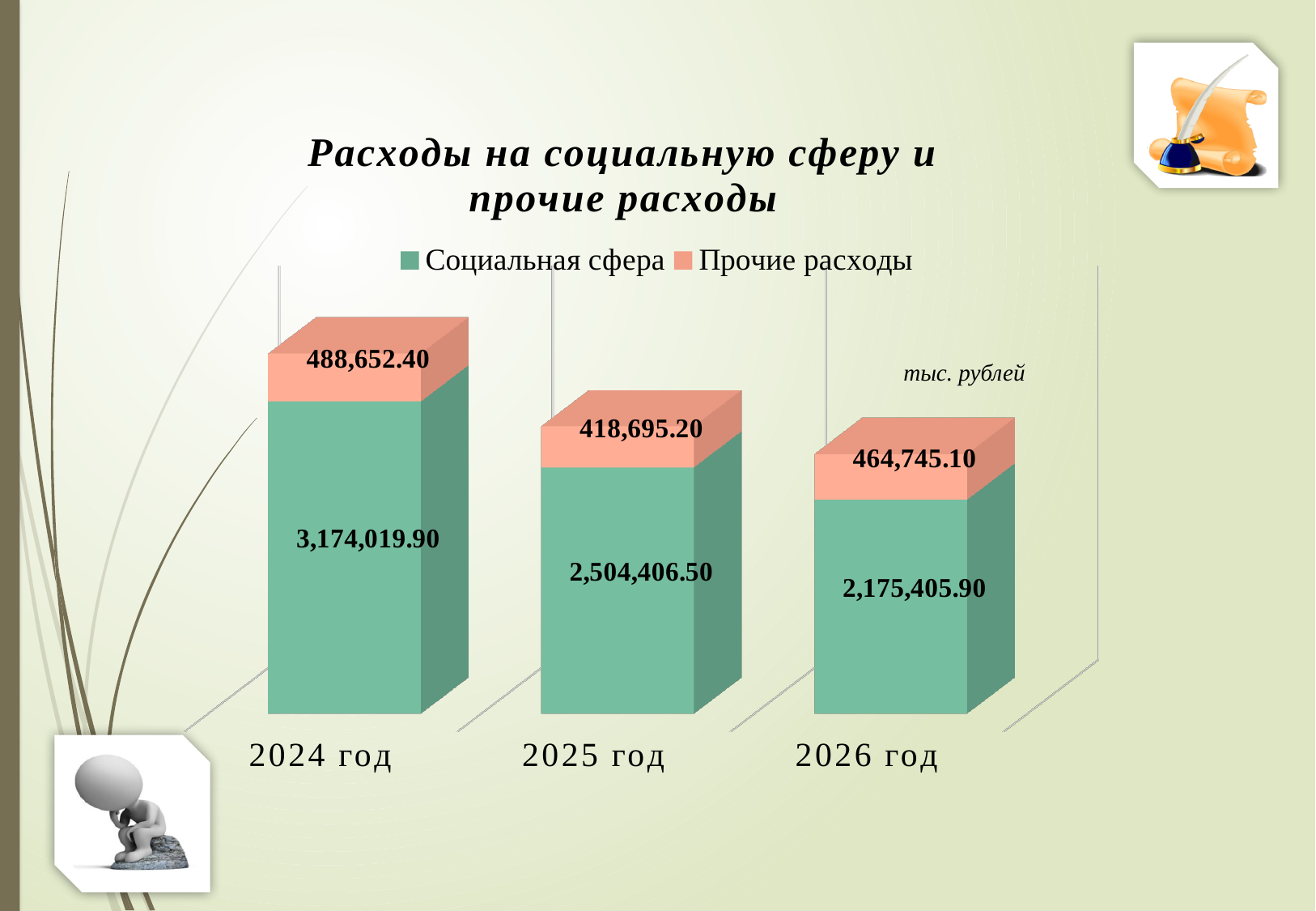
How many series does the legend list? 2 What is the total of the stacked bar for 2026 год? 2,640,151.00 Which year has the lowest value for Прочие расходы? 2025 год How many years are shown on the x axis? 3 What kind of chart is shown on the slide? Stacked bar chart What is the value for Прочие расходы in 2025 год? 418,695.20 What is the value for Прочие расходы in 2026 год? 464,745.10 Which year has the highest value for Социальная сфера? 2024 год What is the difference between the Социальная сфера values for 2024 год and 2025 год? 669,613.40 Which is larger: Прочие расходы in 2025 год or in 2026 год? 2026 год What is the value for Социальная сфера in 2024 год? 3,174,019.90 Do the Социальная сфера values rise or fall from 2024 год to 2026 год? Fall